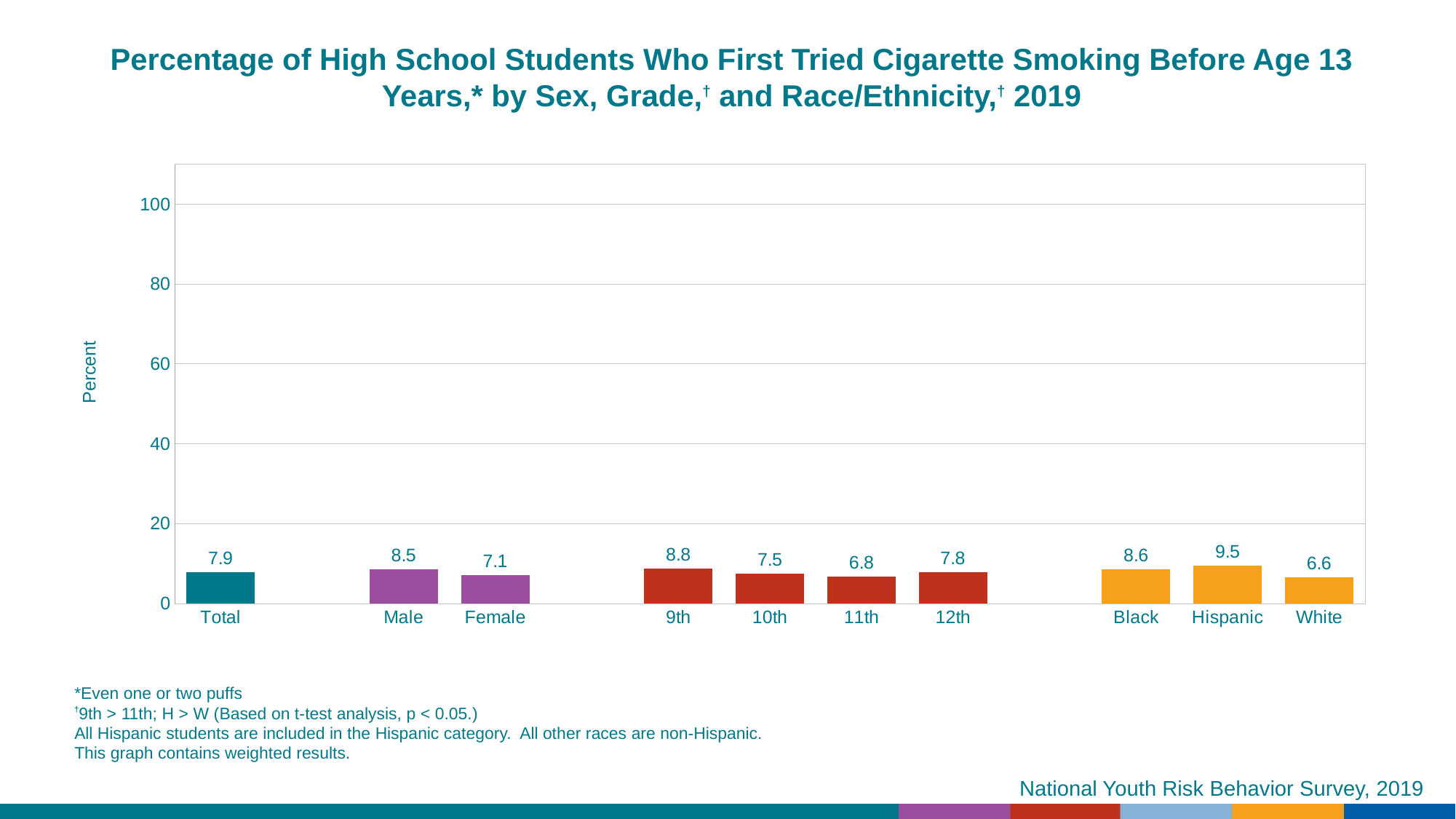
What is the value for 11th grade? 6.8 What is the value for Total? 7.9 How many categories are shown on the x axis? 10 What is the label on the y axis? Percent Is the value for Black students greater or less than 20? less Do the values fall or rise from 9th grade to 11th grade? fall What is the value for Hispanic students? 9.5 Which category has the lowest value? White Which is larger, the value for 9th grade or the value for 12th grade? 9th What is the difference between the values for Male and Female? 1.4 What kind of chart is this? bar chart Which category has the highest value? Hispanic